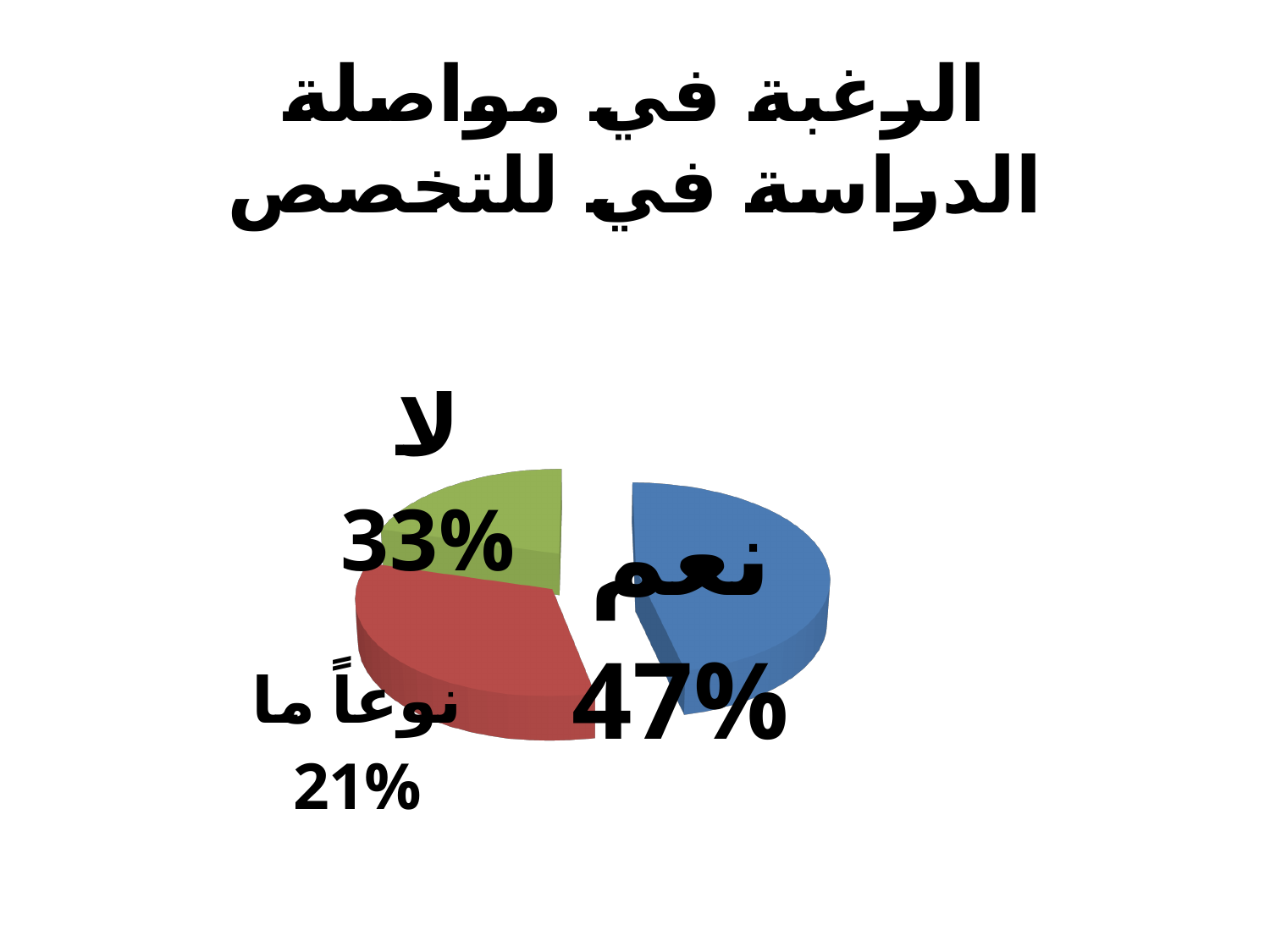
Which category has the smallest share of the pie? نوعاً ما Which category has the largest share of the pie? نعم How many categories does the pie chart show? 3 What percentage is shown for نعم? 47% What kind of chart is shown on the slide? Pie chart Which is larger, the share for نعم or the share for نوعاً ما? نعم What is the difference in percentage points between لا and نوعاً ما? 12 What is the difference in percentage points between نعم and لا? 14 What percentage is shown for لا? 33% What percentage is shown for نوعاً ما? 21% What is the title of the chart? الرغبة في مواصلة الدراسة في للتخصص What colour is the slice labelled نعم? Blue